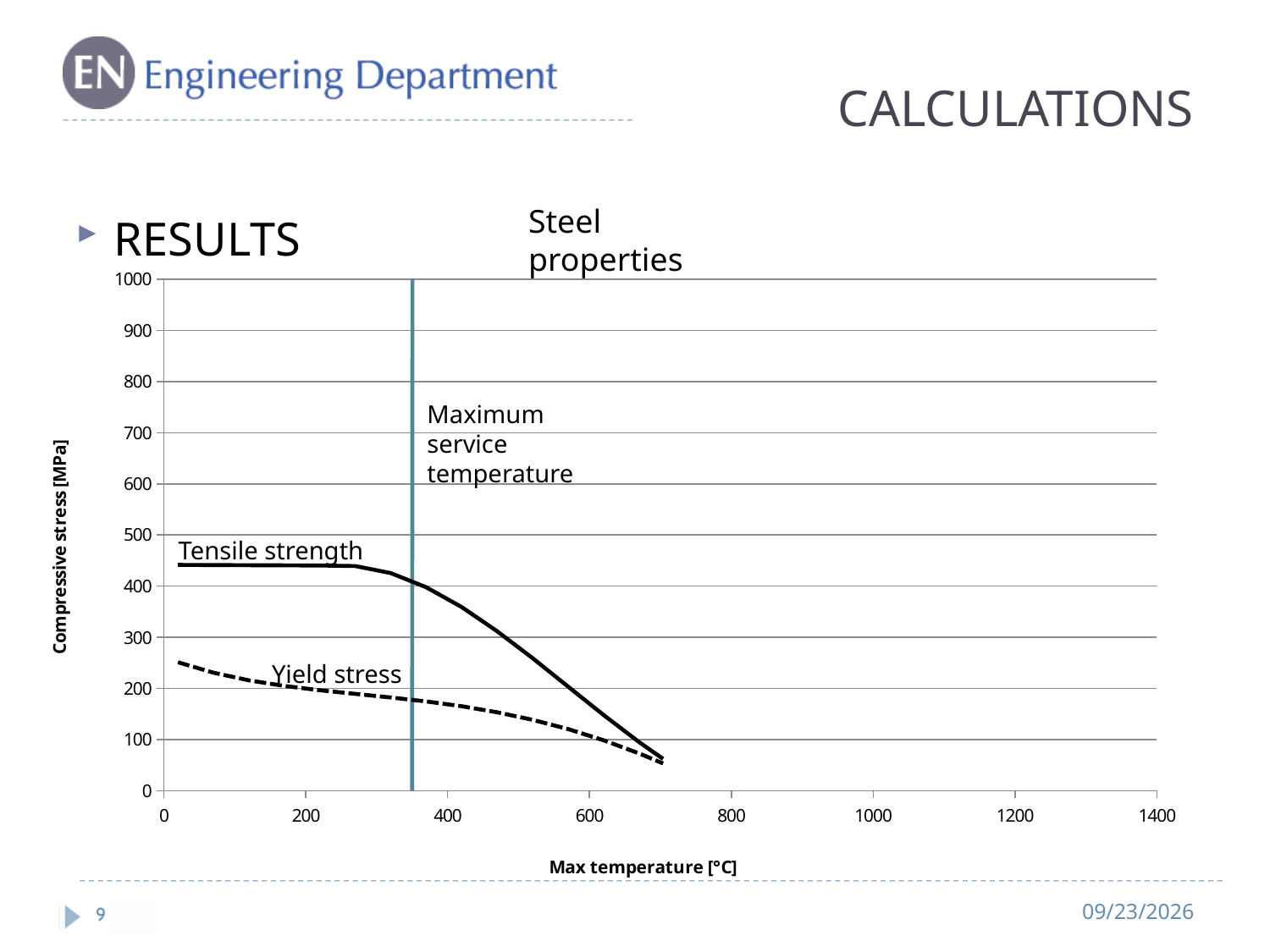
What is the label of the vertical axis of the chart? Compressive stress [MPa] Does the Yield stress curve rise or fall as Max temperature increases? fall Is the Yield stress value at 600 °C greater or less than 200? less What is the title of the chart? Steel properties Is the Maximum service temperature line positioned at a temperature greater or less than 400 °C? less Is the Tensile strength value at 200 °C greater or less than 400? greater At 400 °C, which is higher: Tensile strength or Yield stress? Tensile strength How many data series (curves) are labelled on the chart? 3 What kind of chart is shown on the slide? line chart Does the Tensile strength curve rise or fall as Max temperature increases? fall